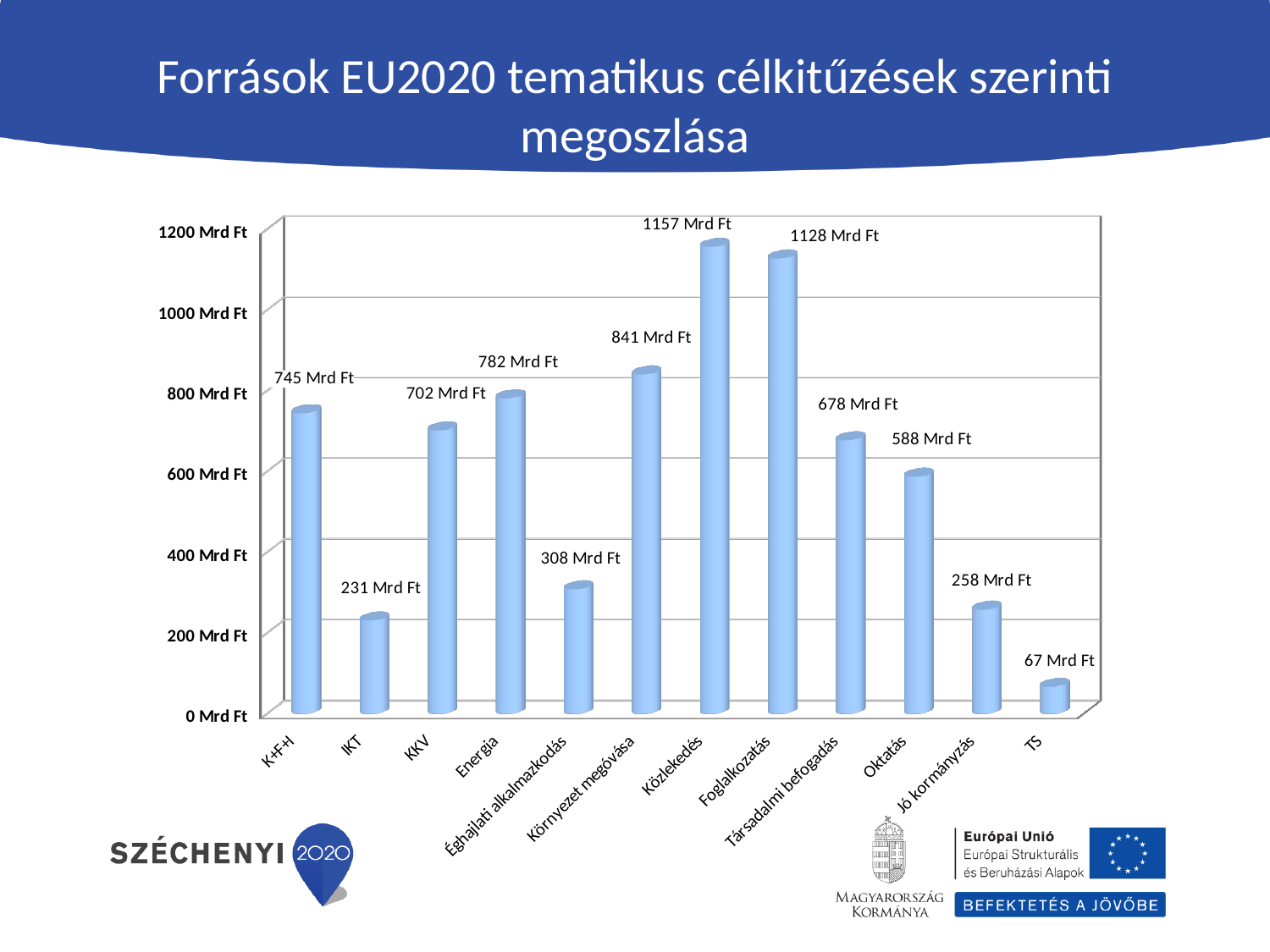
What is the value for Oktatás? 588 Mrd Ft Which is larger, the value for K+F+I or the value for Környezet megóvása? Környezet megóvása Which category has the highest value? Közlekedés What is the title of the slide? Források EU2020 tematikus célkitűzések szerinti megoszlása What is the difference between the values for Energia and KKV? 80 Mrd Ft What is the difference between the values for Közlekedés and Foglalkoztatás? 29 Mrd Ft How many categories are shown on the x axis? 12 What is the value for Közlekedés? 1157 Mrd Ft What kind of chart is shown on the slide? bar chart Which category has the lowest value? TS What is the value for IKT? 231 Mrd Ft Is the value for Társadalmi befogadás greater or less than 600 Mrd Ft? greater